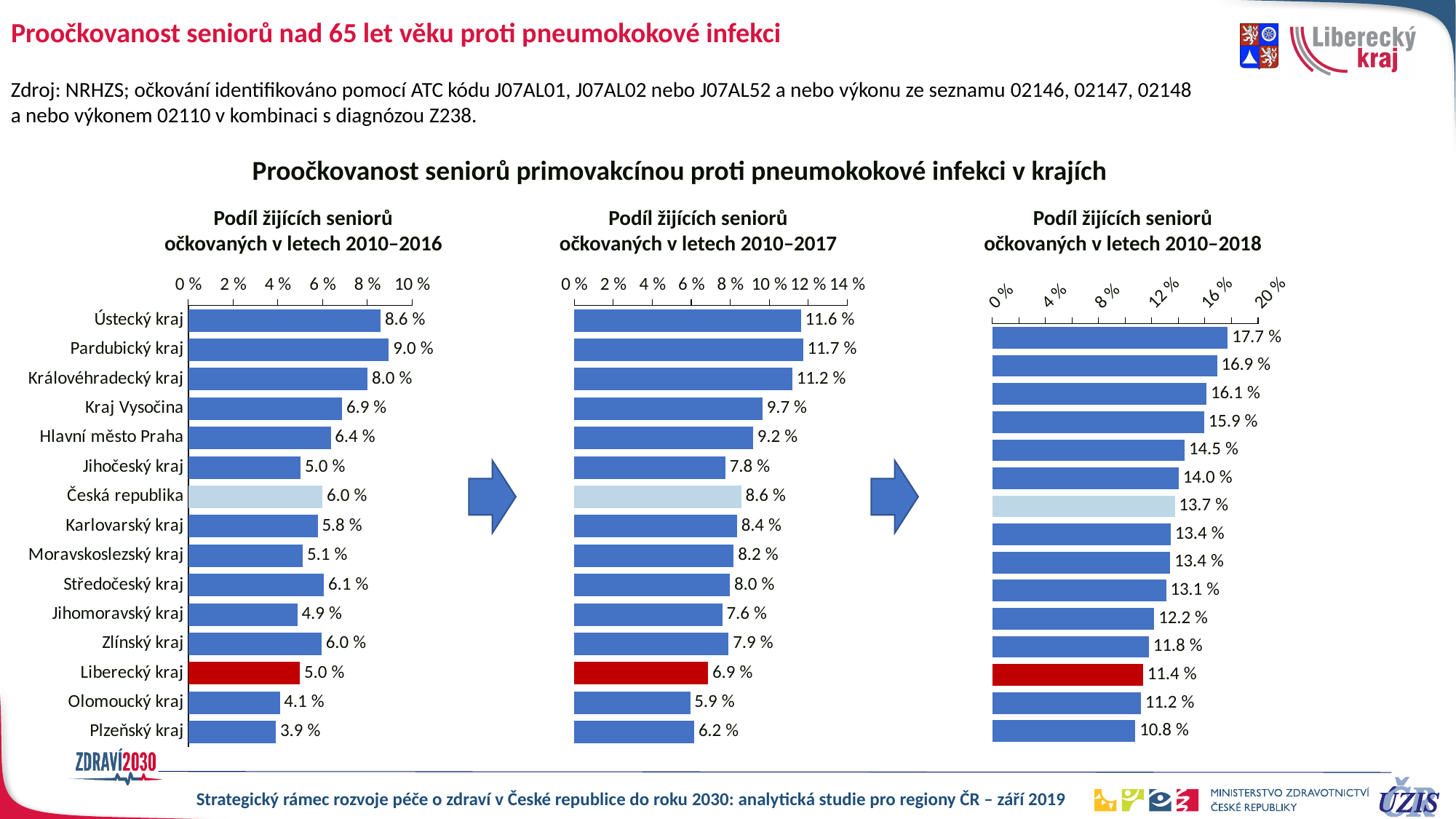
In the left chart (2010–2016), which region has the lowest value? Plzeňský kraj In the left chart (2010–2016), what is the value for Liberecký kraj? 5.0 % How many bars does the left chart (2010–2016) contain? 15 In the right chart (2010–2018), what is the value of the lowest bar at the bottom? 10.8 % In the left chart (2010–2016), which region has the highest value? Pardubický kraj What type of chart is used on this slide? Bar chart In the left chart (2010–2016), which is larger: Kraj Vysočina or Hlavní město Praha? Kraj Vysočina In the right chart (2010–2018), what is the difference between the red bar (Liberecký kraj) and the light blue bar (Česká republika)? 2.3 % In the left chart (2010–2016), what is the difference between Pardubický kraj and Plzeňský kraj? 5.1 % In the middle chart (2010–2017), what is the value of the light blue bar (Česká republika)? 8.6 % In the middle chart (2010–2017), what is the value of the red bar (Liberecký kraj)? 6.9 % In the right chart (2010–2018), what is the value of the top bar? 17.7 %